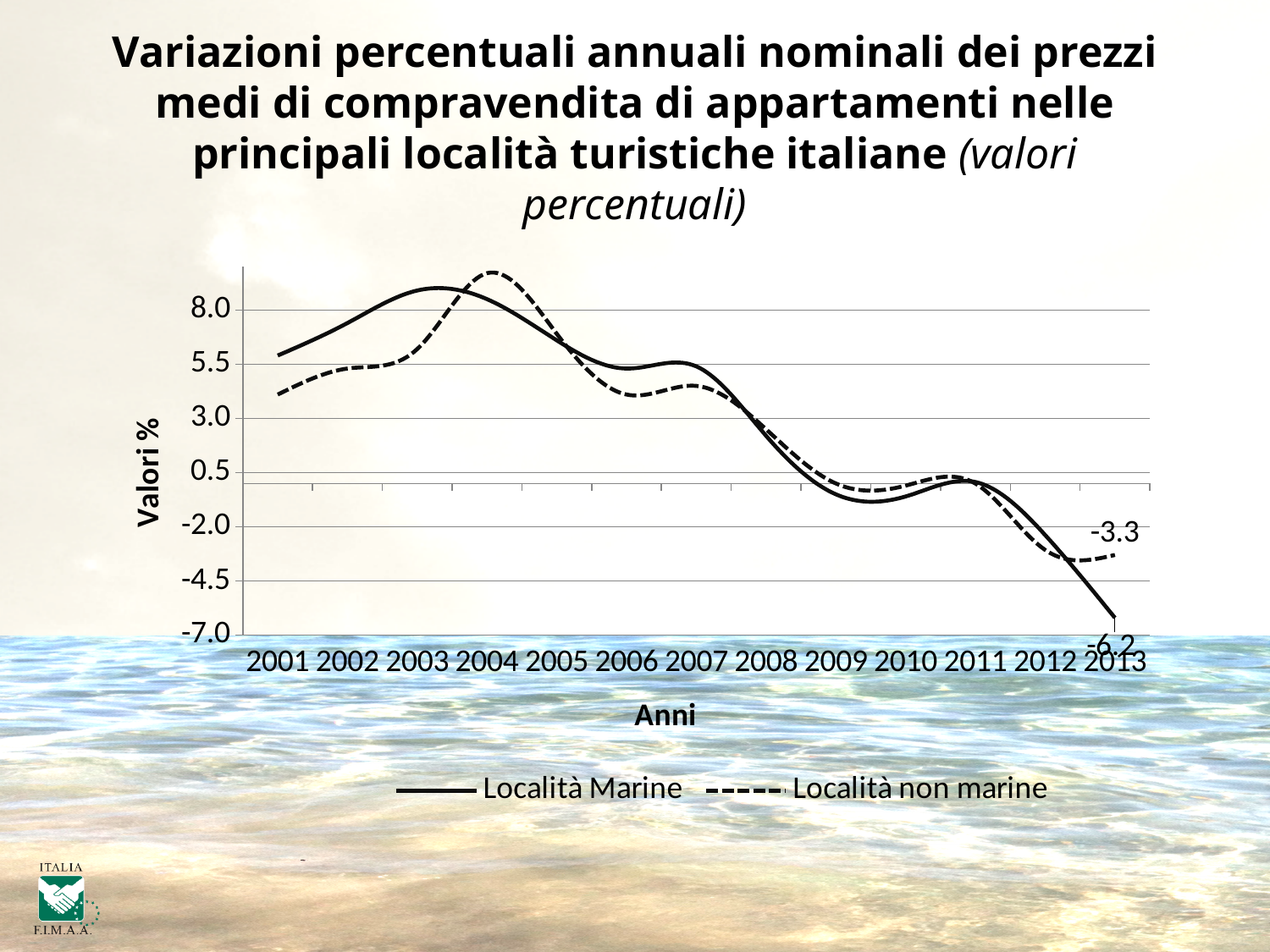
Is the value for Località Marine in 2009 greater or less than 0.5? less What kind of chart is shown on the slide? line chart What is the difference between the 2013 values of Località non marine and Località Marine? 2.9 In which year does Località non marine reach its highest value? 2004 In 2013, which series has the higher value, Località Marine or Località non marine? Località non marine What is the value for Località non marine in 2013? -3.3 Do the values for Località Marine rise or fall overall from 2001 to 2013? fall What is the value for Località Marine in 2013? -6.2 Is the value for Località non marine in 2004 greater or less than 8.0? greater How many series does the legend list? 2 How many years are shown on the x axis? 13 What is the title of the y axis? Valori %